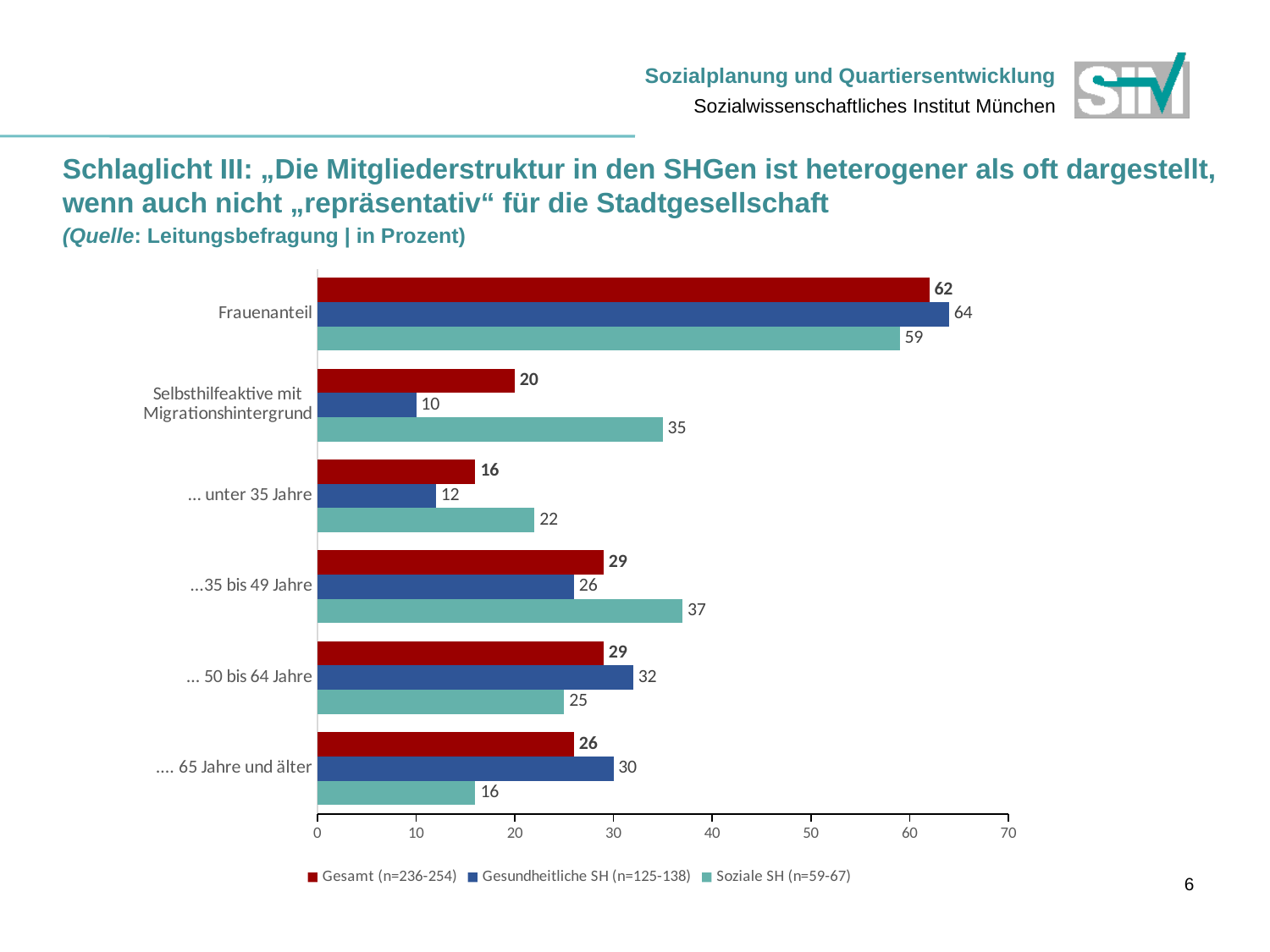
How many categories are shown on the chart? 6 What is the sample size range given in the legend for Soziale SH? n=59-67 For ... 50 bis 64 Jahre, which series has the larger value: Gesundheitliche SH or Soziale SH? Gesundheitliche SH What is the Gesamt value for Frauenanteil? 62 What is the difference between the Soziale SH and Gesundheitliche SH values for Selbsthilfeaktive mit Migrationshintergrund? 25 Which category has the highest Gesamt value? Frauenanteil What is the Soziale SH value for Selbsthilfeaktive mit Migrationshintergrund? 35 How many series does the legend list? 3 Is the Soziale SH value for Frauenanteil greater or less than 50? greater Which category has the lowest Gesundheitliche SH value? Selbsthilfeaktive mit Migrationshintergrund What is the Gesundheitliche SH value for ... 65 Jahre und älter? 30 What kind of chart is shown on the slide? bar chart